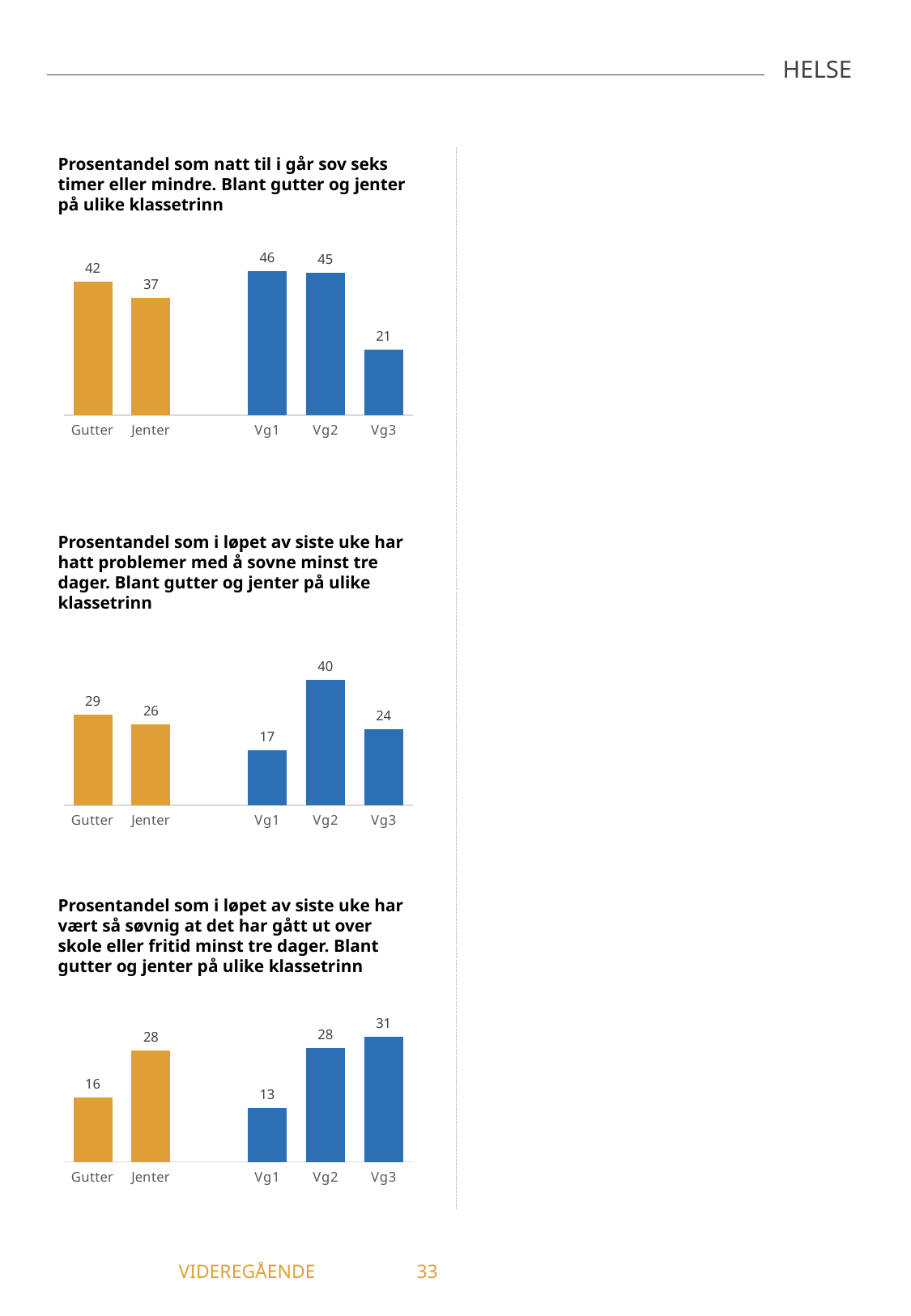
In the bottom chart (so sleepy it affected school or leisure), what is the value for Vg1? 13 In the top chart (sleeping six hours or less), which category has the lowest value? Vg3 In the top chart (sleeping six hours or less), what is the difference between Vg1 and Vg3? 25 In the bottom chart (so sleepy it affected school or leisure), what is the difference between Jenter and Gutter? 12 In the top chart (sleeping six hours or less), what is the value for Gutter? 42 In the middle chart (problems falling asleep), which category has the highest value? Vg2 In the middle chart (problems falling asleep), what is the value for Vg2? 40 What type of chart is the bottom chart on the slide? Bar chart In the middle chart (problems falling asleep), which is larger, Gutter or Jenter? Gutter In the top chart (sleeping six hours or less), how many bars are plotted? 5 In the bottom chart (so sleepy it affected school or leisure), which category has the highest value? Vg3 In the middle chart (problems falling asleep), what is the difference between Gutter and Jenter? 3